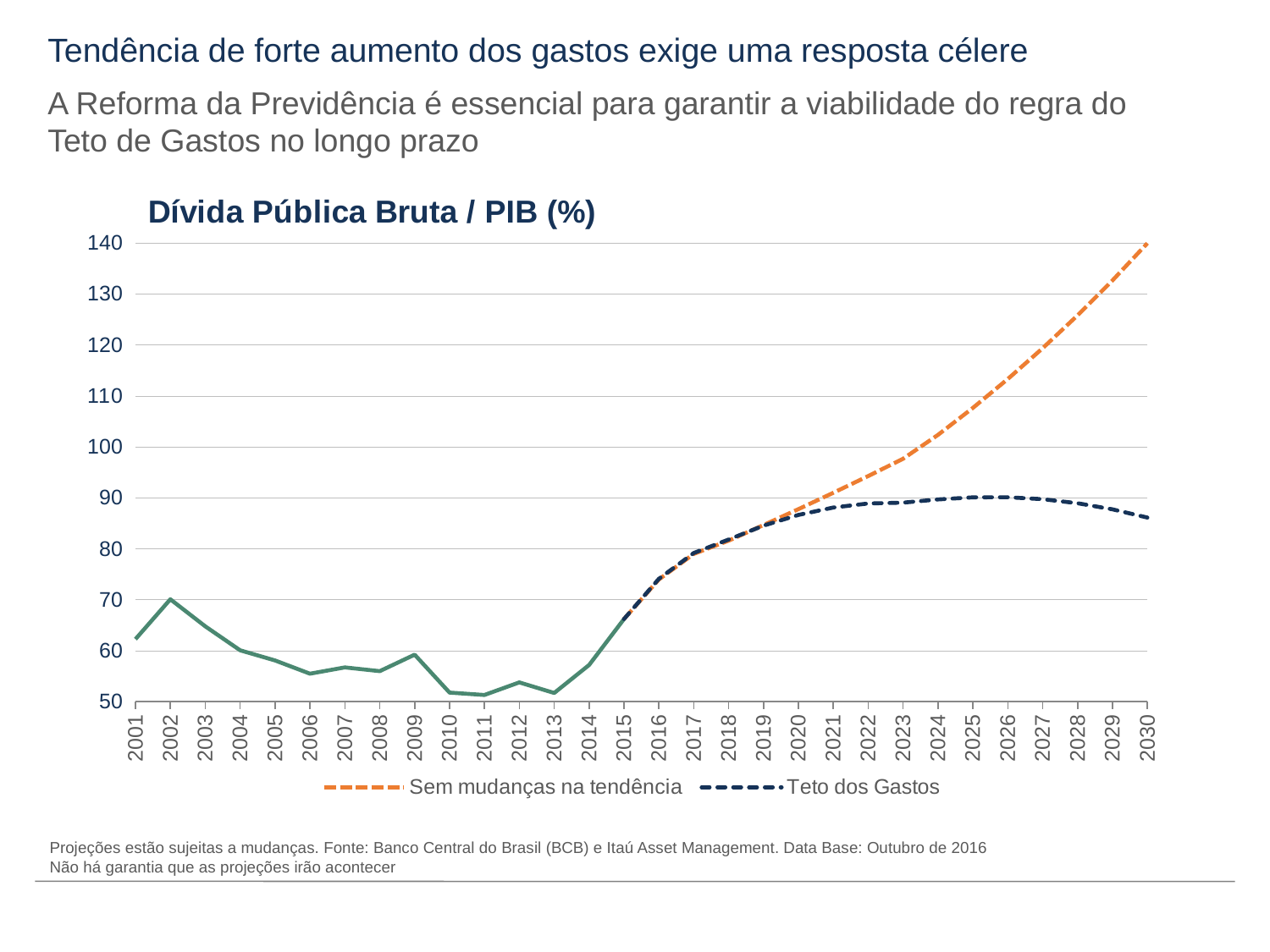
Is the value in 2011 greater or less than 60? less Is the value for 'Teto dos Gastos' in 2030 greater or less than 90? less Is the value for 'Sem mudanças na tendência' in 2028 greater or less than 120? greater In 2030, which series has the higher value: 'Sem mudanças na tendência' or 'Teto dos Gastos'? Sem mudanças na tendência Does the 'Sem mudanças na tendência' series rise or fall from 2020 to 2030? rise What is the title of the chart? Dívida Pública Bruta / PIB (%) How many series does the chart legend list? 2 Does the 'Teto dos Gastos' series rise or fall from 2026 to 2030? fall What kind of chart is shown on the slide? line chart What are the two series named in the legend? Sem mudanças na tendência; Teto dos Gastos How many years are shown on the x axis? 30